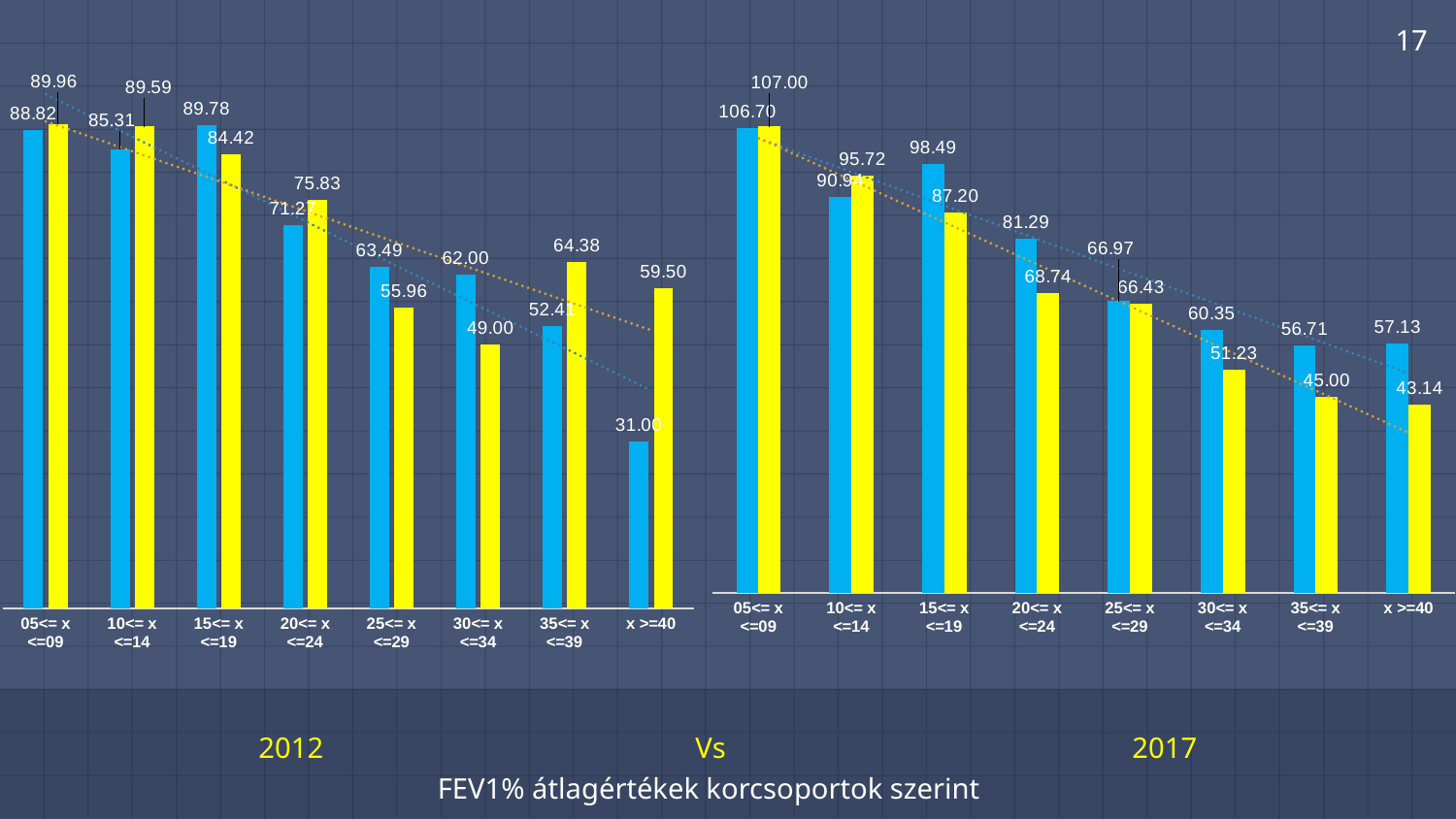
In the right (2017) chart, what is the value of the blue bar for the 05<= x <=09 age group? 106.70 What is the title text shown below the two charts? FEV1% átlagértékek korcsoportok szerint In the right (2017) chart, which is larger for the 15<= x <=19 age group, the blue bar or the yellow bar? the blue bar In the left (2012) chart, which is larger for the 30<= x <=34 age group, the blue bar or the yellow bar? the blue bar In the right (2017) chart, which age group has the highest yellow bar? 05<= x <=09 In the left (2012) chart, what is the value of the blue bar for the x >=40 age group? 31.00 What type of chart is the left (2012) chart? bar chart In the right (2017) chart, do the yellow bar values generally rise or fall from the youngest to the oldest age group? fall How many age-group categories are shown on the x axis of the right (2017) chart? 8 In the left (2012) chart, what is the difference between the yellow bar (64.38) and the blue bar (52.41) for the 35<= x <=39 age group? 11.97 In the right (2017) chart, what is the value of the yellow bar for the 35<= x <=39 age group? 45.00 In the left (2012) chart, which age group has the lowest blue bar? x >=40